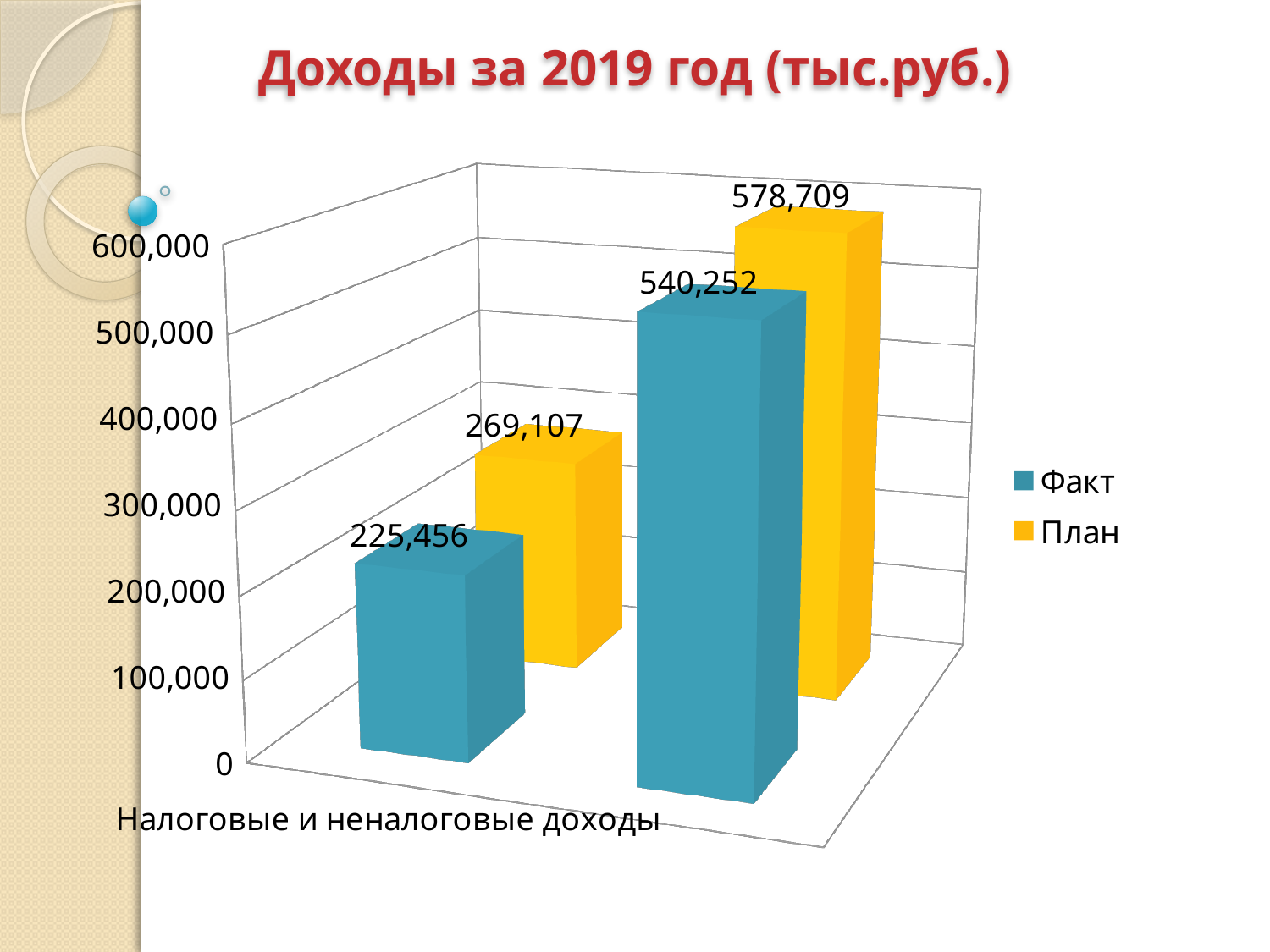
What type of chart is shown on the slide? bar chart What is the План value for Налоговые и неналоговые доходы? 269,107 Is the Факт value for Налоговые и неналоговые доходы greater or less than 300,000? less What is the highest value shown on the chart? 578,709 How many series does the legend list? 2 What are the two series named in the legend? Факт and План What is the lowest value shown on the chart? 225,456 Which series has the tallest bar on the chart? План What is the title of the chart? Доходы за 2019 год (тыс.руб.) What is the difference between План and Факт for Налоговые и неналоговые доходы? 43,651 What is the Факт value for Налоговые и неналоговые доходы? 225,456 For Налоговые и неналоговые доходы, which is larger: Факт or План? План